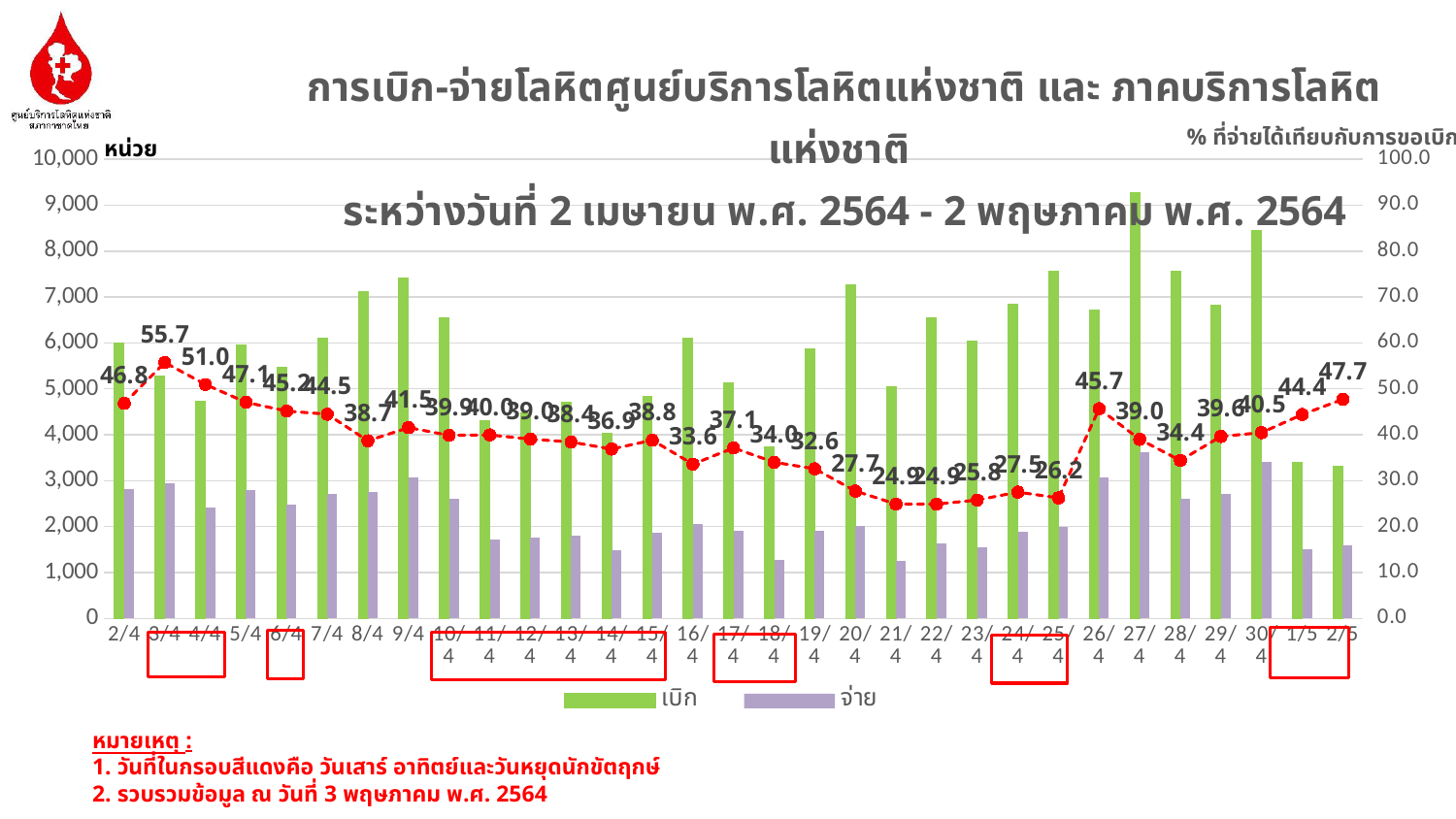
How many series does the legend list? 2 What percentage value is labelled on the red line for 26/4? 45.7 What is the difference between the percentage labels for 3/4 and 2/4? 8.9 How many dates are shown along the x axis? 31 On which date does the red percentage line reach its highest labelled value? 3/4 Is the green (เบิก) bar for 27/4 greater or less than 9,000? greater Is the green (เบิก) bar for 1/5 greater or less than 4,000? less What percentage value is labelled on the red line for 3/4? 55.7 Is the purple (จ่าย) bar for 21/4 greater or less than 2,000? less Which date has the taller green (เบิก) bar, 27/4 or 30/4? 27/4 Does the red percentage line rise or fall from 3/4 to 21/4? fall What percentage value is labelled on the red line for 2/5? 47.7